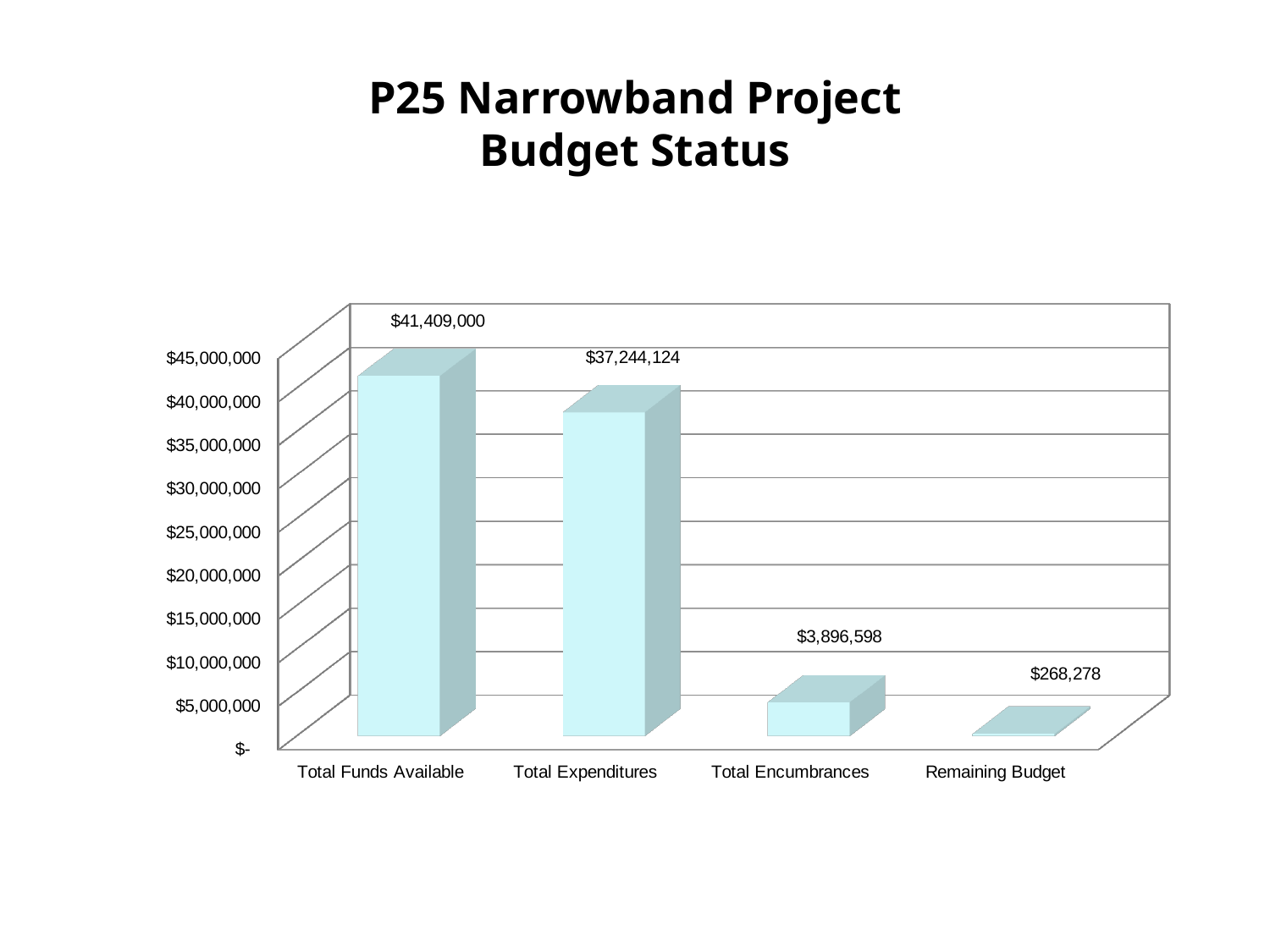
What is the value for Remaining Budget? $268,278 How many categories are shown on the chart? 4 What is the value for Total Encumbrances? $3,896,598 Which category has the lowest value? Remaining Budget Which is larger, Total Expenditures or Total Encumbrances? Total Expenditures What kind of chart is shown on the slide? Bar chart What is the value for Total Funds Available? $41,409,000 What is the title of the slide? P25 Narrowband Project Budget Status What is the difference between Total Encumbrances and Remaining Budget? $3,628,320 Which category has the highest value? Total Funds Available What is the value for Total Expenditures? $37,244,124 What is the difference between Total Funds Available and Total Expenditures? $4,164,876